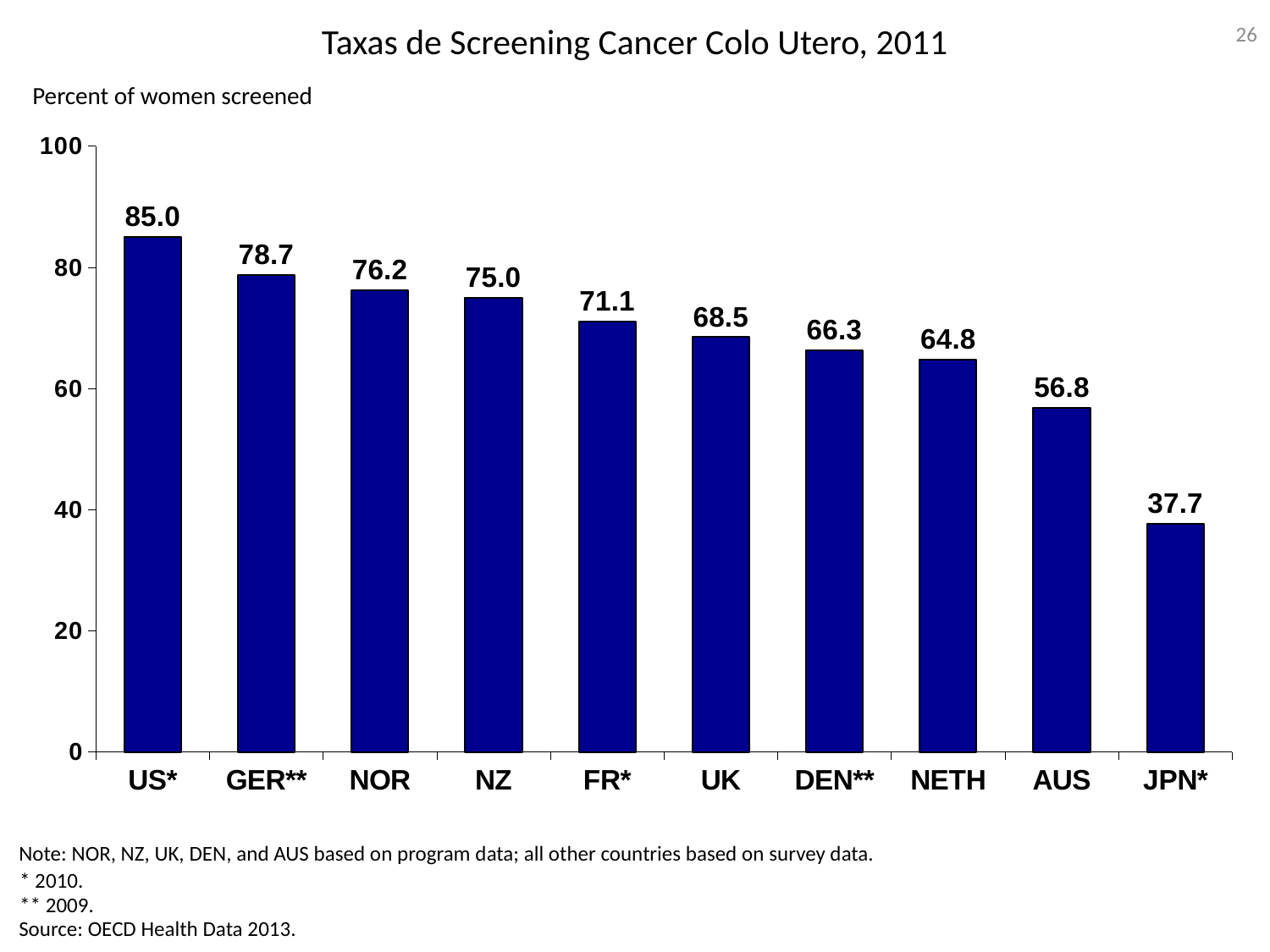
What is the value for NETH? 64.8 Which country has the lowest value? JPN* What is the value for JPN*? 37.7 What kind of chart is shown on the slide? bar chart What is the difference between the values for US* and JPN*? 47.3 Is the value for AUS greater or less than 60? less What is the difference between the values for GER** and NOR? 2.5 Which is larger, the value for UK or the value for DEN**? UK What is the value for US*? 85.0 Which country has the highest value? US* What is the title of the chart? Taxas de Screening Cancer Colo Utero, 2011 How many countries are shown in the chart? 10